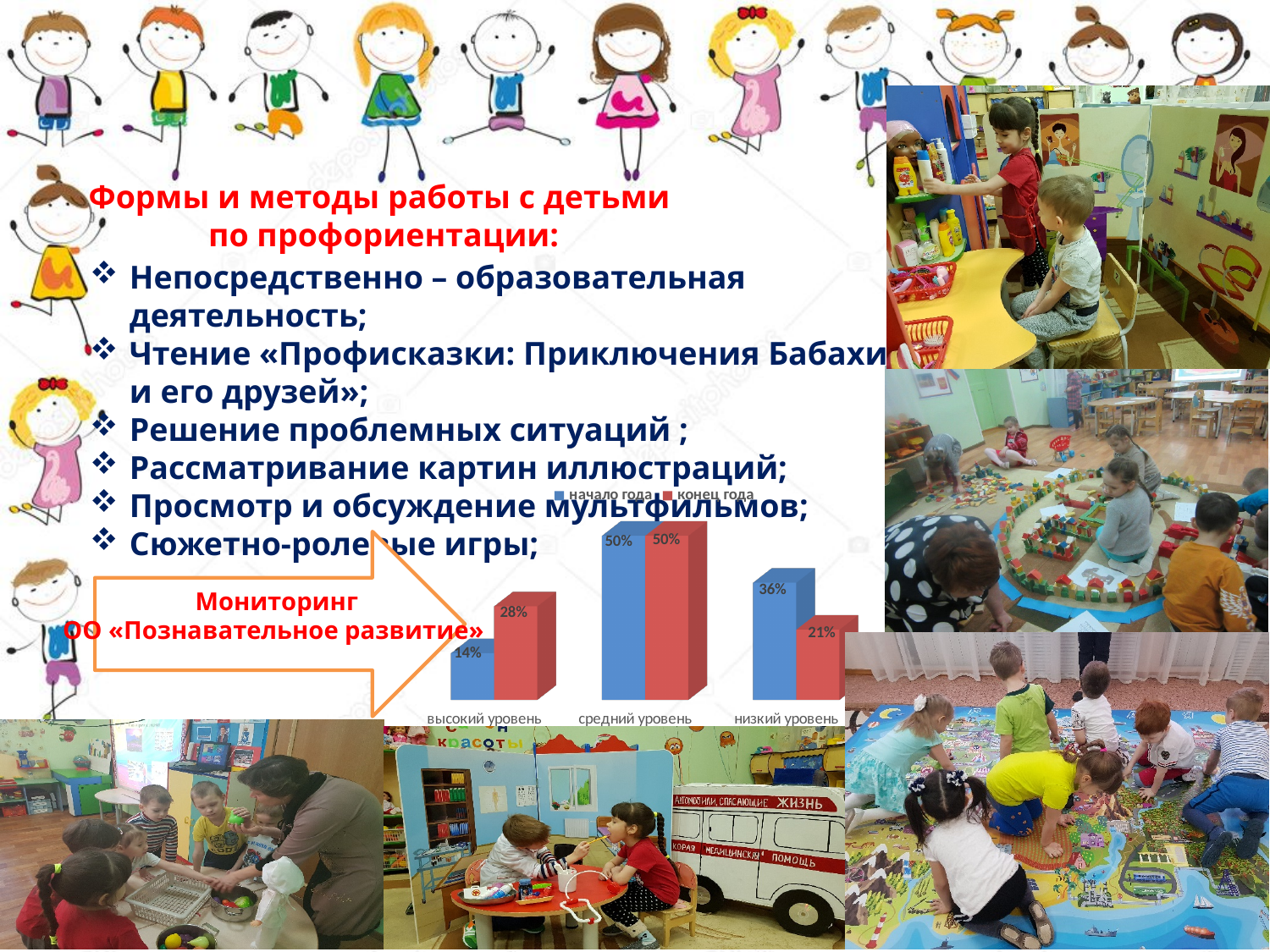
How many categories are shown on the chart's x axis? 3 In the «низкий уровень» category, which is larger: «начало года» or «конец года»? начало года What is the value for «конец года» in the «низкий уровень» category? 21% What is the difference between «конец года» and «начало года» in the «высокий уровень» category? 14% Which category has the highest value for «начало года»? средний уровень What is the value for «конец года» in the «высокий уровень» category? 28% What is the value for «средний уровень» at the end of the year («конец года»)? 50% Which category has the lowest value for «конец года»? низкий уровень What is the value for «начало года» in the «низкий уровень» category? 36% How many series does the chart legend list? 2 What is the value for «начало года» in the «высокий уровень» category? 14% What kind of chart is shown on the slide? bar chart